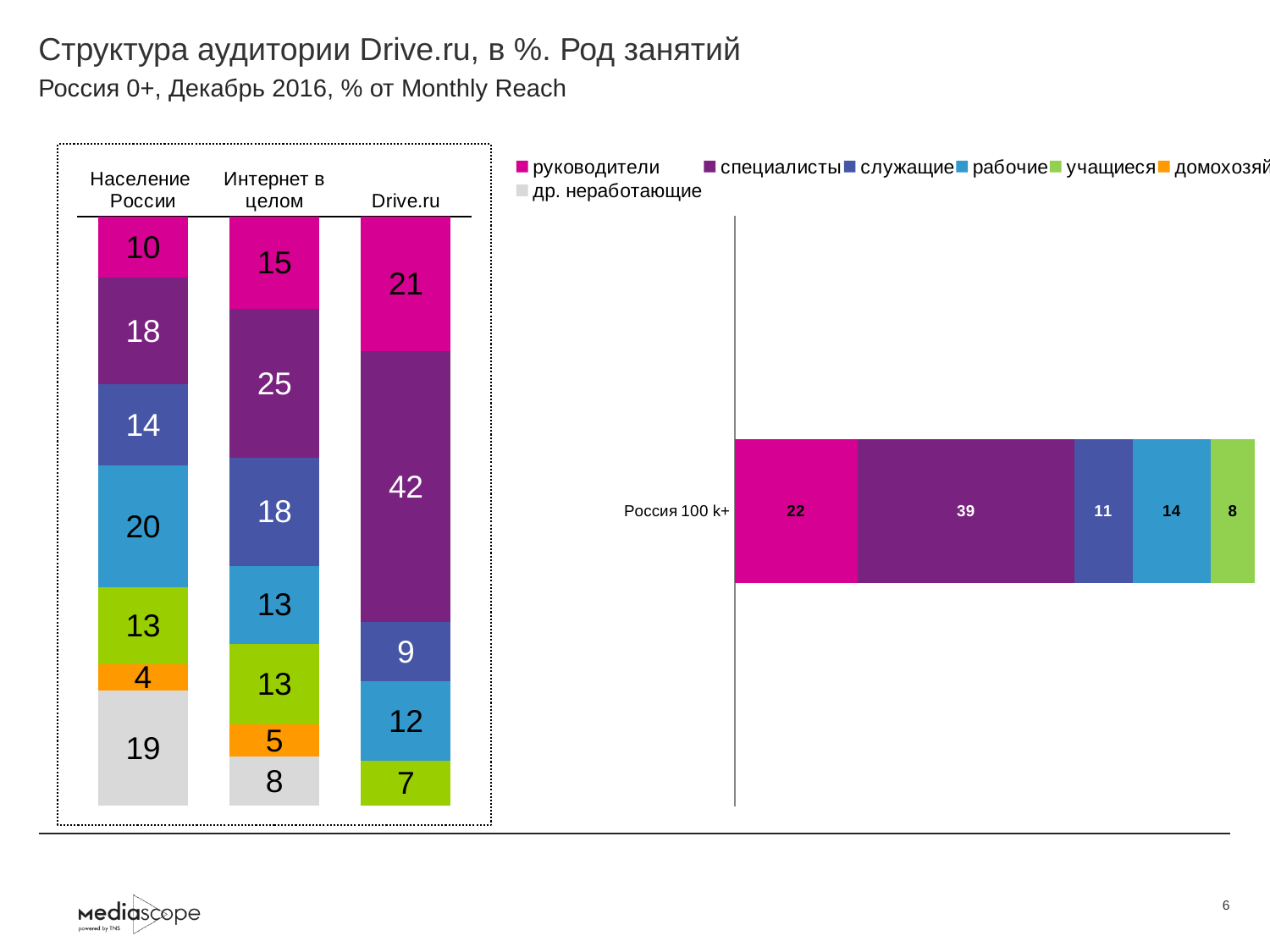
In the left chart, which segment is the smallest in the Население России bar? домохозяйки In the left chart, what is the value for рабочие in the Интернет в целом bar? 13 How many series does the legend list? 7 What kind of chart is the right chart? stacked bar chart In the right chart, what is the value for специалисты in the Россия 100 k+ bar? 39 How many bars (categories) does the left chart show? 3 In the left chart, what is the difference between the руководители values for Drive.ru and Население России? 11 In the left chart, what is the value for руководители in the Население России bar? 10 In the left chart, which segment is the largest in the Drive.ru bar? специалисты In the right chart, what is the total of the Россия 100 k+ bar? 94 In the left chart, which is larger: the служащие value for Интернет в целом or for Drive.ru? Интернет в целом In the left chart, what is the value for специалисты in the Drive.ru bar? 42